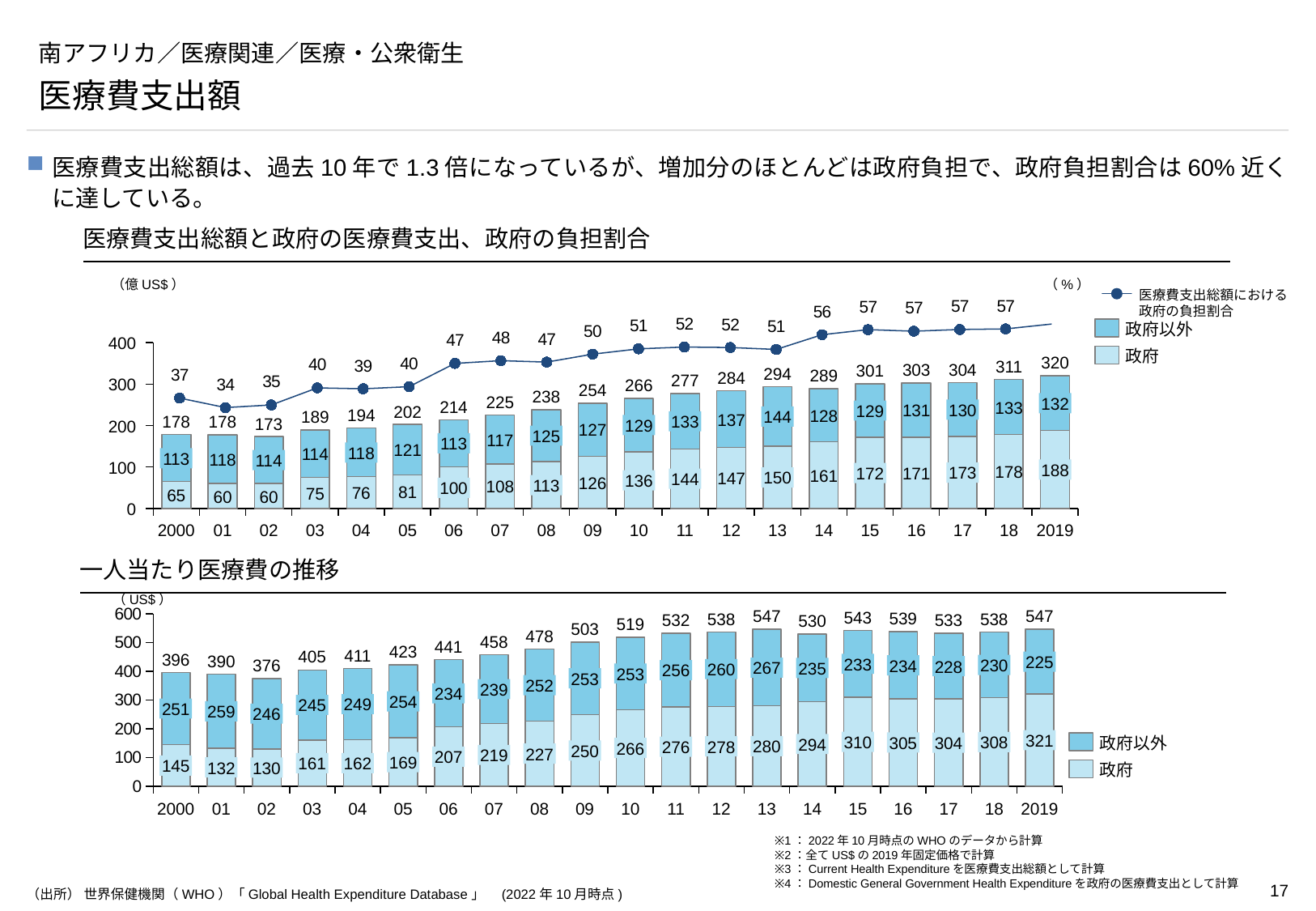
In the bottom chart (一人当たり医療費の推移), what is the 政府以外 value for 2013? 267 In the bottom chart (一人当たり医療費の推移), which year has the lowest stacked bar total? 02 In the top chart (医療費支出総額と政府の医療費支出、政府の負担割合), what is the 政府の負担割合 line value for 2014? 56 In the top chart (医療費支出総額と政府の医療費支出、政府の負担割合), how many series does the legend list? 3 In the top chart (医療費支出総額と政府の医療費支出、政府の負担割合), which year has the lowest stacked bar total? 02 In the top chart (医療費支出総額と政府の医療費支出、政府の負担割合), does the 政府の負担割合 line generally rise or fall from 2000 to 2018? rise In the top chart (医療費支出総額と政府の医療費支出、政府の負担割合), what is the total of the stacked bar for 2010? 266 In the top chart (医療費支出総額と政府の医療費支出、政府の負担割合), what is the difference between the 政府 values for 2019 and 2000? 123 In the bottom chart (一人当たり医療費の推移), how many years are shown on the x axis? 20 In the top chart (医療費支出総額と政府の医療費支出、政府の負担割合), what is the 政府 value for 2019? 188 In the bottom chart (一人当たり医療費の推移), is the 政府 value for 2019 larger than the 政府以外 value for 2019? Yes What kind of chart is the bottom chart (一人当たり医療費の推移)? stacked bar chart